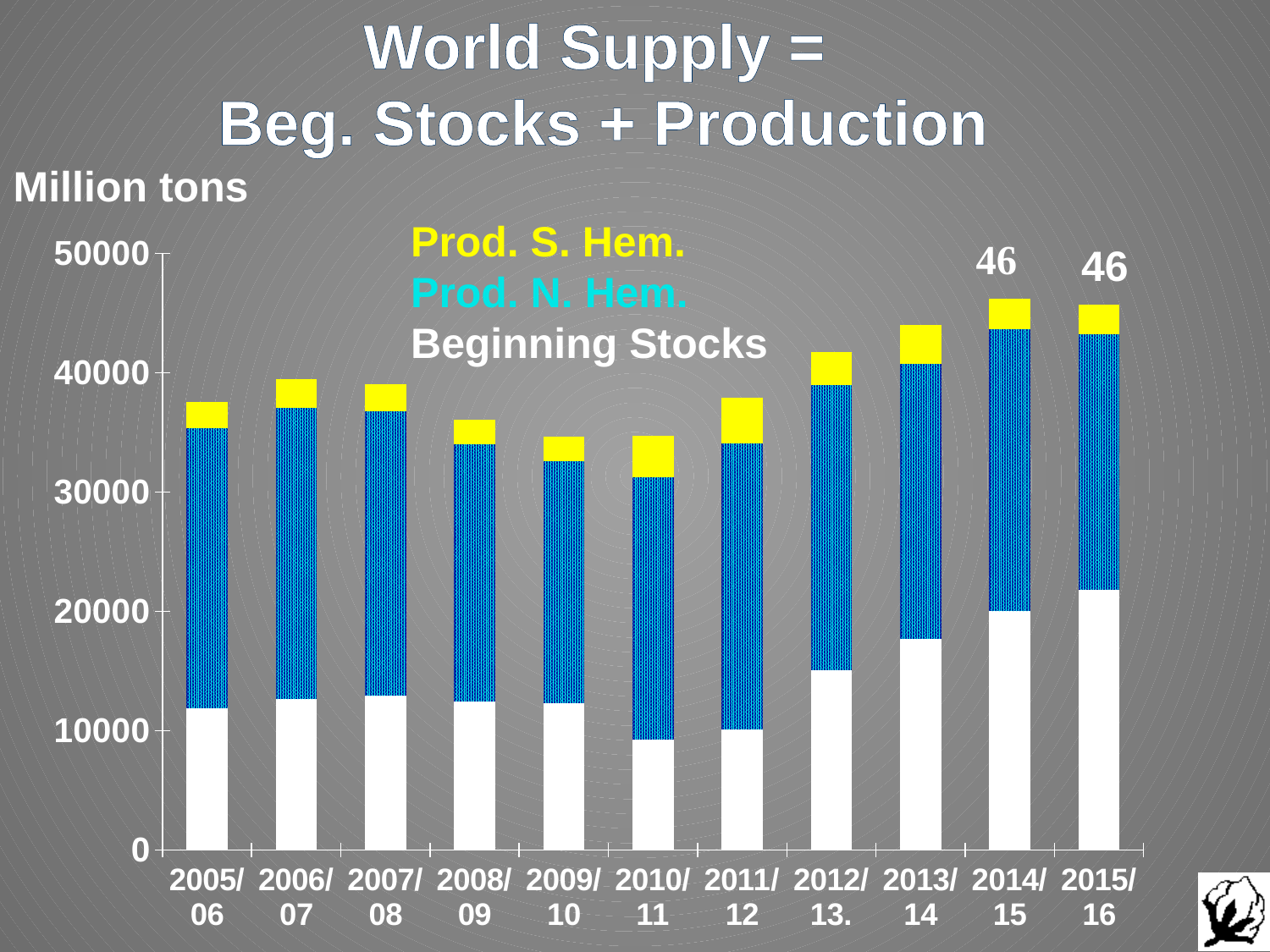
What unit is given for the y axis? Million tons Do the Beginning Stocks rise or fall from 2011/12 to 2015/16? rise What value is printed above the 2014/15 bar? 46 How many seasons (categories) are shown on the x axis? 11 What value is printed above the 2015/16 bar? 46 Is the Beginning Stocks value for 2015/16 greater or less than 20000? greater Is the total height of the 2009/10 bar greater or less than 40000? less How many series does the legend list? 3 Which bar is taller in total, 2012/13 or 2008/09? 2012/13 Which season has the highest Beginning Stocks? 2015/16 What kind of chart is shown on the slide? bar chart Is the Beginning Stocks value for 2010/11 greater or less than 10000? less